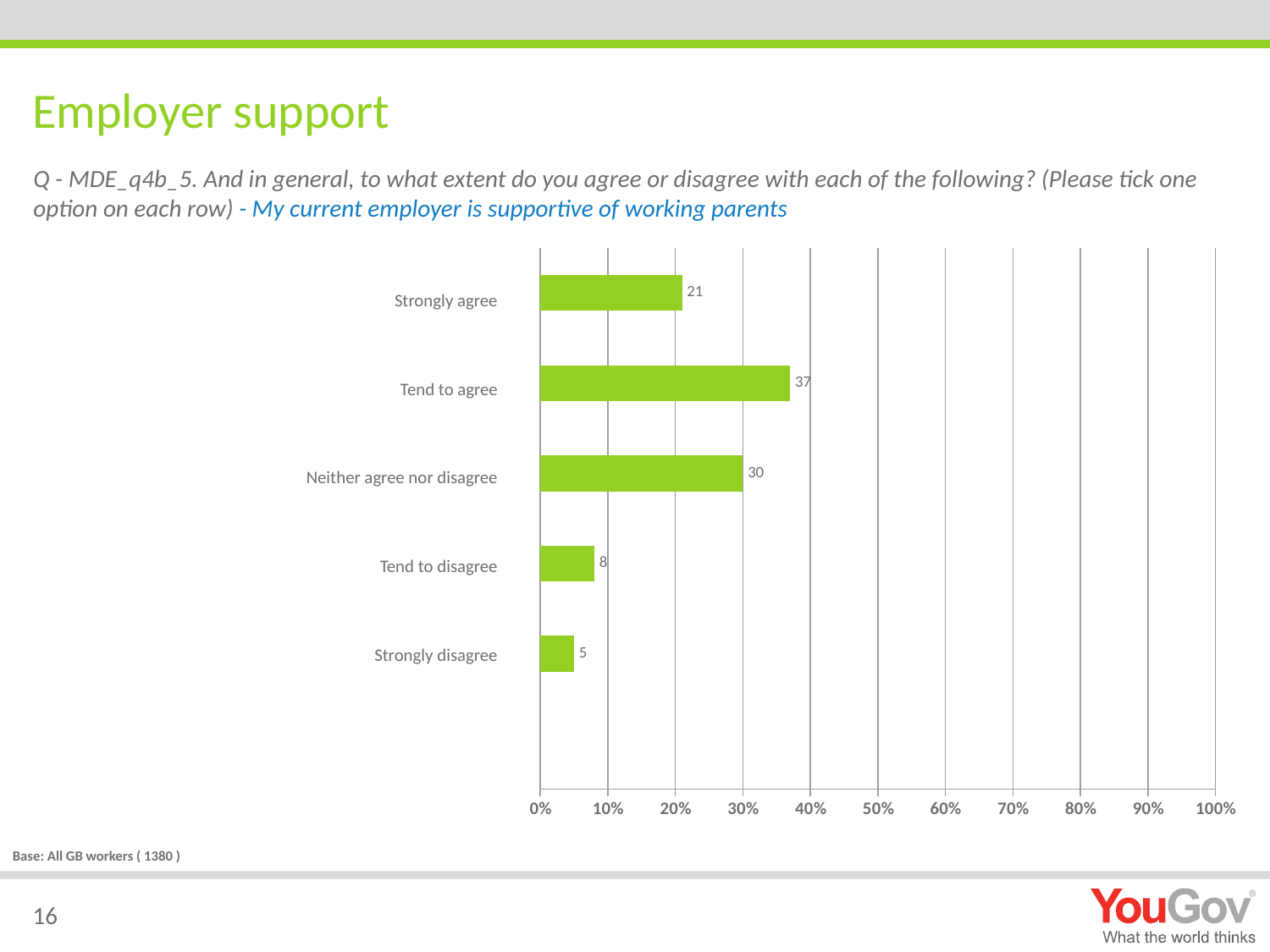
What is the difference between the values for Tend to agree and Neither agree nor disagree? 7 Which category has the highest value? Tend to agree What is the value for Strongly disagree? 5 How many categories are shown in the chart? 5 What is the value for Neither agree nor disagree? 30 Is the value for Tend to agree greater or less than 30%? greater Which category has the lowest value? Strongly disagree What is the value for Strongly agree? 21 Which is larger, the value for Strongly agree or the value for Tend to disagree? Strongly agree What kind of chart is shown on the slide? Bar chart What is the value for Tend to agree? 37 What is the title of the slide? Employer support